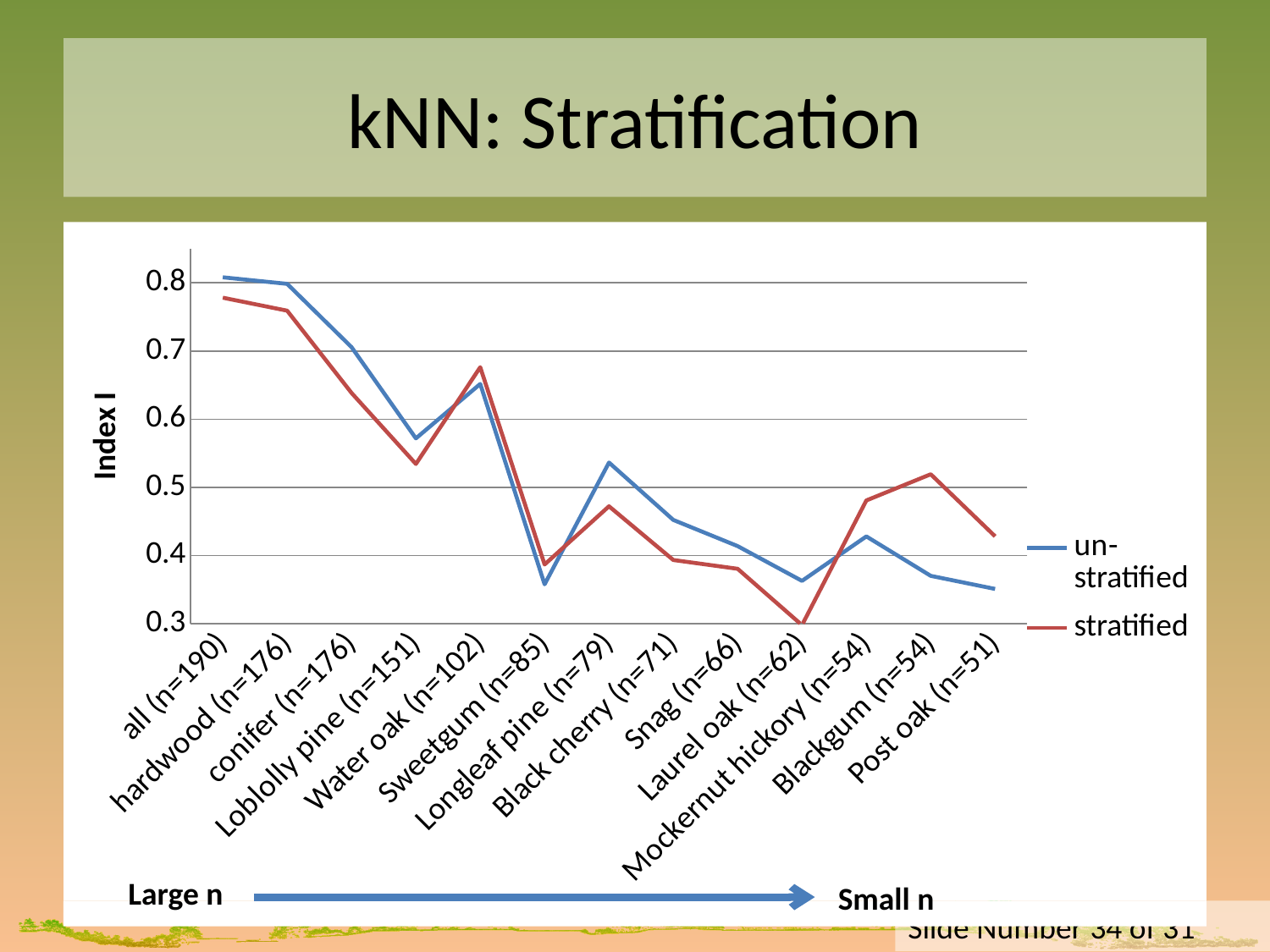
How many series does the legend list? 2 What kind of chart is shown on the slide? line chart Is the un-stratified value for Loblolly pine (n=151) greater or less than 0.6? less Is the stratified value for Blackgum (n=54) greater or less than 0.5? greater Is the stratified value for Water oak (n=102) greater or less than 0.6? greater How many categories are plotted along the x axis? 13 Which category has the highest un-stratified value? all (n=190) For Blackgum (n=54), which series has the larger value, un-stratified or stratified? stratified What is the title of the y axis? Index I For Longleaf pine (n=79), which series has the larger value, un-stratified or stratified? un-stratified Which category has the lowest stratified value? Laurel oak (n=62)